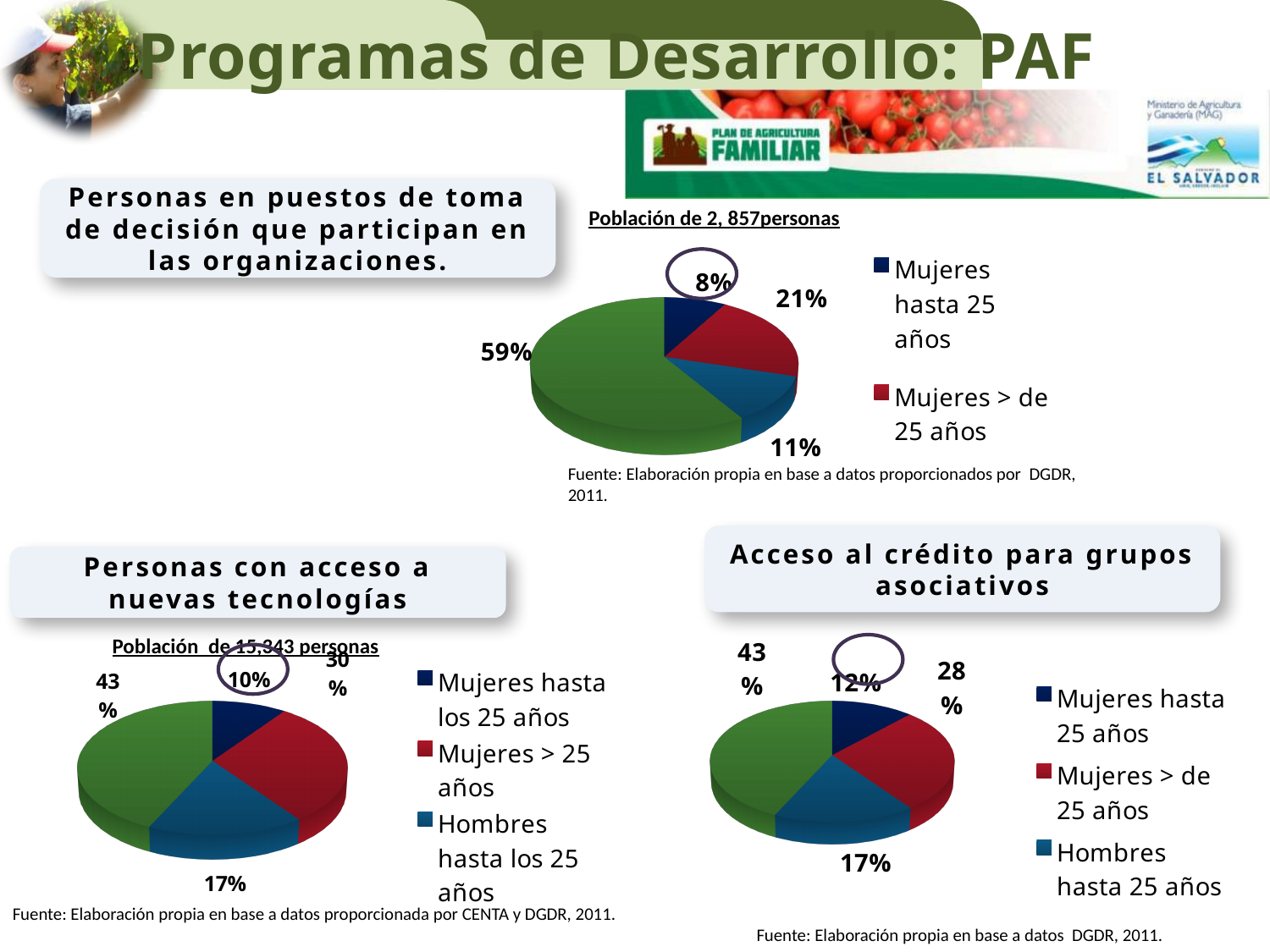
In the chart titled 'Personas con acceso a nuevas tecnologías', what percentage is shown for 'Mujeres hasta los 25 años'? 10% In the chart titled 'Personas con acceso a nuevas tecnologías', what is the difference in percentage points between 'Mujeres > 25 años' and 'Mujeres hasta los 25 años'? 20 In the chart titled 'Acceso al crédito para grupos asociativos', which is larger: 'Mujeres hasta 25 años' or 'Hombres hasta 25 años'? Hombres hasta 25 años In the chart titled 'Personas en puestos de toma de decisión que participan en las organizaciones', what percentage is shown for 'Mujeres hasta 25 años'? 8% In the chart titled 'Personas en puestos de toma de decisión que participan en las organizaciones', what is the largest slice's percentage? 59% In the chart titled 'Acceso al crédito para grupos asociativos', what percentage is shown for 'Mujeres > de 25 años'? 28% In the chart titled 'Personas en puestos de toma de decisión que participan en las organizaciones', what percentage is shown for 'Mujeres > de 25 años'? 21% How many slices does the pie chart titled 'Acceso al crédito para grupos asociativos' have? 4 In the chart titled 'Acceso al crédito para grupos asociativos', how many entries does the legend list? 3 In the chart titled 'Personas en puestos de toma de decisión que participan en las organizaciones', what is the smallest slice's percentage? 8% In the chart titled 'Personas con acceso a nuevas tecnologías', what percentage is shown for 'Hombres hasta los 25 años'? 17% What type of chart is used in the 'Personas con acceso a nuevas tecnologías' section? Pie chart